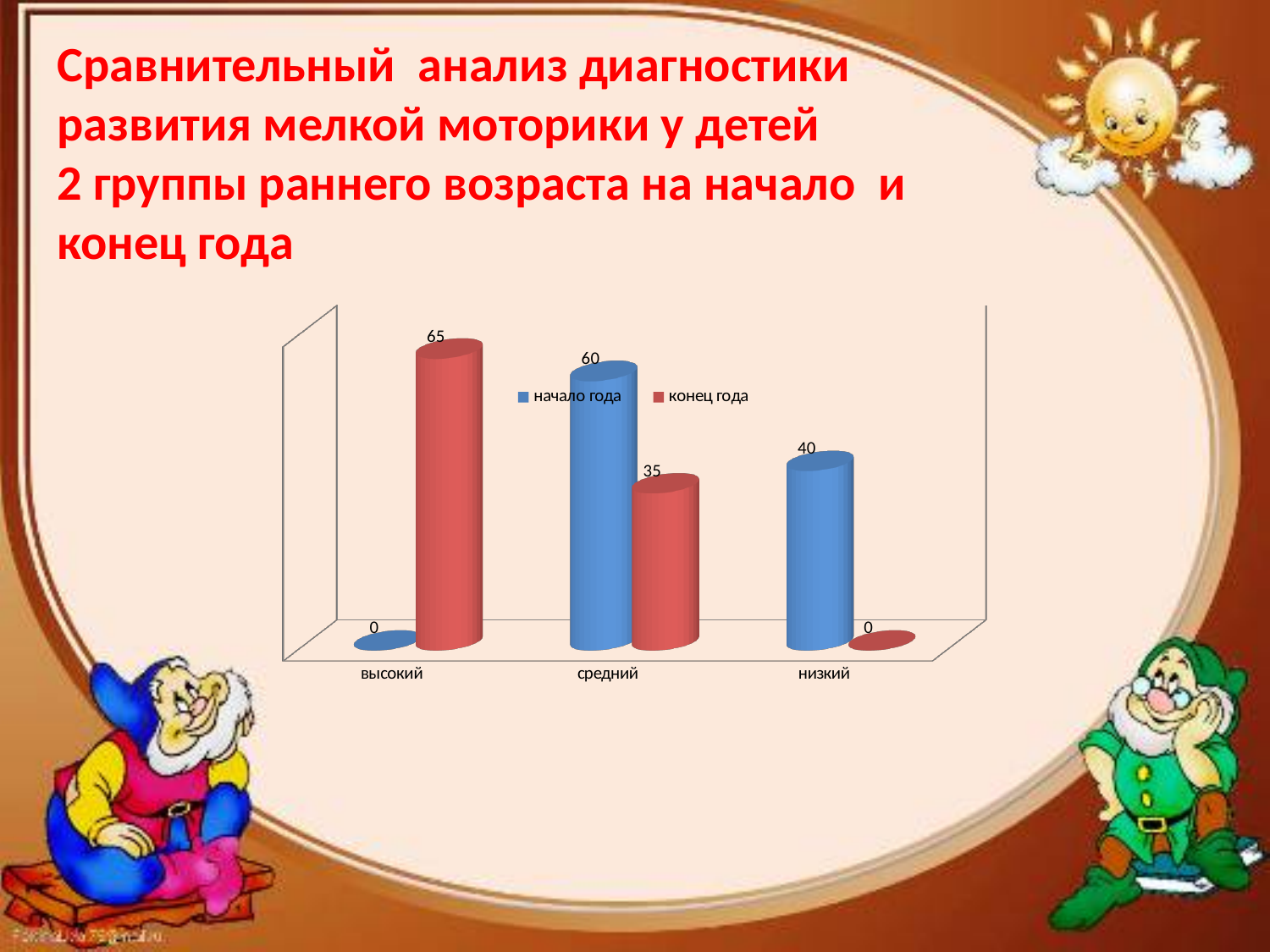
What is the value for 'конец года' in the 'высокий' category? 65 What is the value for 'конец года' in the 'низкий' category? 0 What is the value for 'начало года' in the 'средний' category? 60 How many series does the legend list? 2 What is the value for 'начало года' in the 'высокий' category? 0 Which category has the lowest value for 'конец года'? низкий Which is larger in the 'низкий' category: 'начало года' or 'конец года'? начало года What is the difference between 'начало года' and 'конец года' in the 'средний' category? 25 What kind of chart is shown on the slide? bar chart What colour are the bars for the 'конец года' series? red How many categories are shown on the x axis? 3 Which category has the highest value for 'начало года'? средний